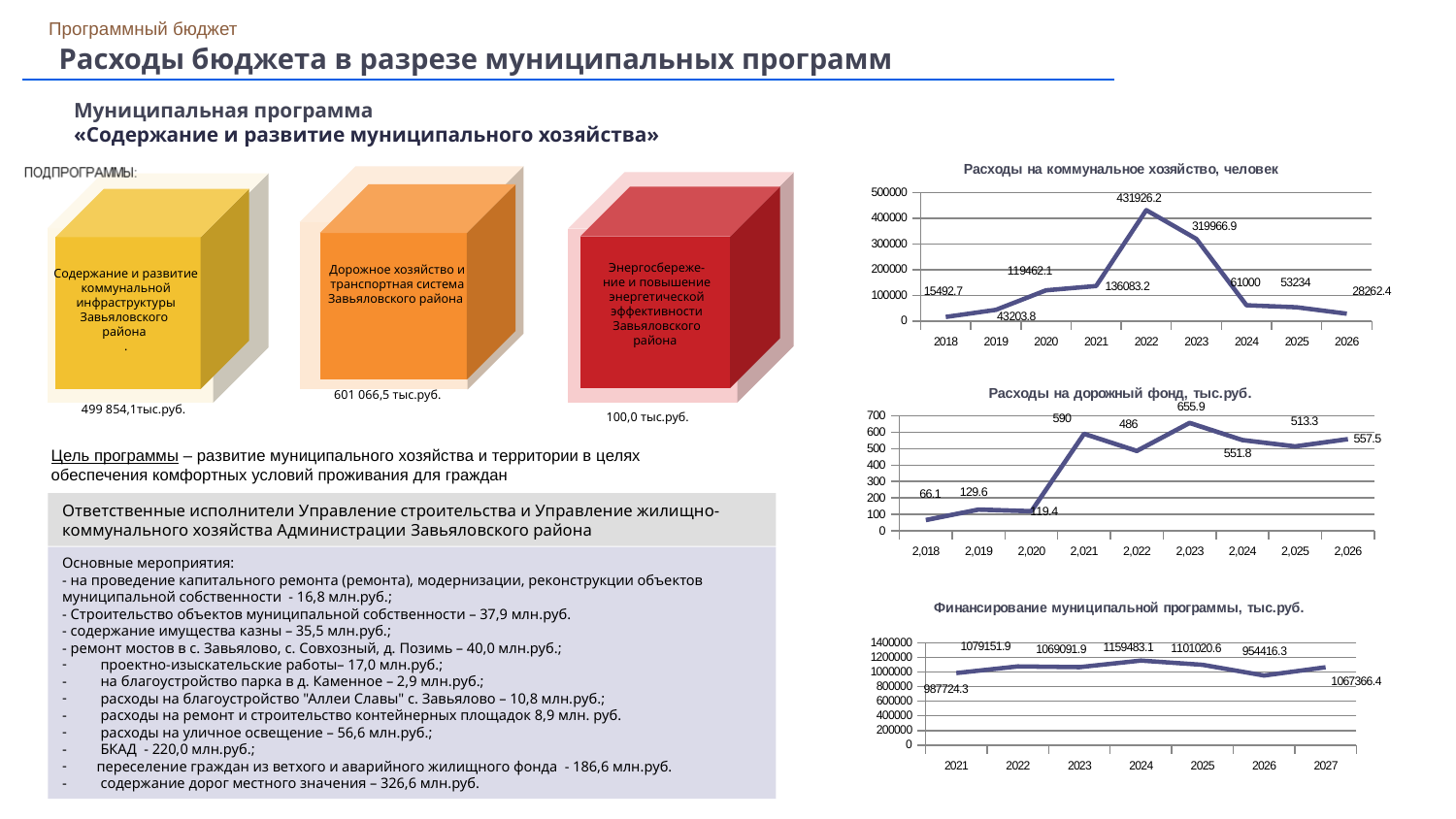
In the chart 'Расходы на дорожный фонд, тыс.руб.', what is the value for 2023? 655.9 In the chart 'Расходы на дорожный фонд, тыс.руб.', which year has the highest value? 2023 In the chart 'Расходы на коммунальное хозяйство, человек', how many years are plotted? 9 In the chart 'Финансирование муниципальной программы, тыс.руб.', what is the value for 2024? 1159483.1 In the chart 'Финансирование муниципальной программы, тыс.руб.', which year has the lowest value? 2026 In the chart 'Расходы на коммунальное хозяйство, человек', which year has the lowest value? 2018 In the chart 'Финансирование муниципальной программы, тыс.руб.', how many years are plotted? 7 In the chart 'Расходы на коммунальное хозяйство, человек', is the value for 2023 larger or smaller than the value for 2024? larger What type of chart is 'Расходы на дорожный фонд, тыс.руб.'? line chart In the chart 'Расходы на коммунальное хозяйство, человек', what is the value for 2022? 431926.2 In the chart 'Финансирование муниципальной программы, тыс.руб.', does the value rise or fall from 2025 to 2026? fall In the chart 'Расходы на дорожный фонд, тыс.руб.', what is the difference between the values for 2021 and 2022? 104